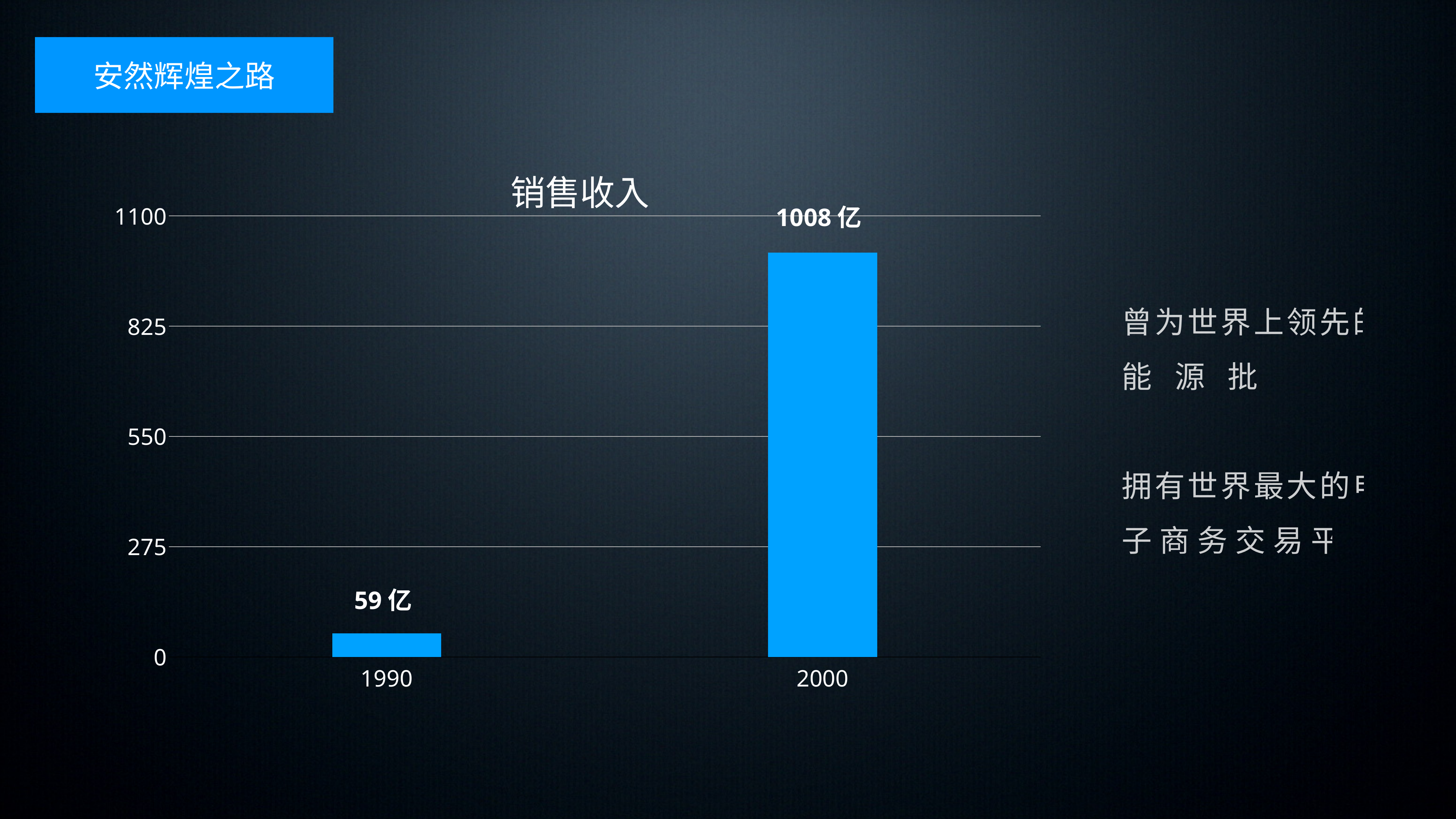
What is the title of the chart? 销售收入 What is the difference between the values for 2000 and 1990? 949 亿 Which year has the lowest value? 1990 What is the value for 1990? 59 亿 What is the value for 2000? 1008 亿 What kind of chart is this? bar chart Is the value for 1990 greater or less than 275? less Which year has the highest value? 2000 How many categories are shown on the x axis? 2 Do the values rise or fall from 1990 to 2000? rise Which is larger, the value for 1990 or the value for 2000? 2000 Is the value for 2000 greater or less than 825? greater